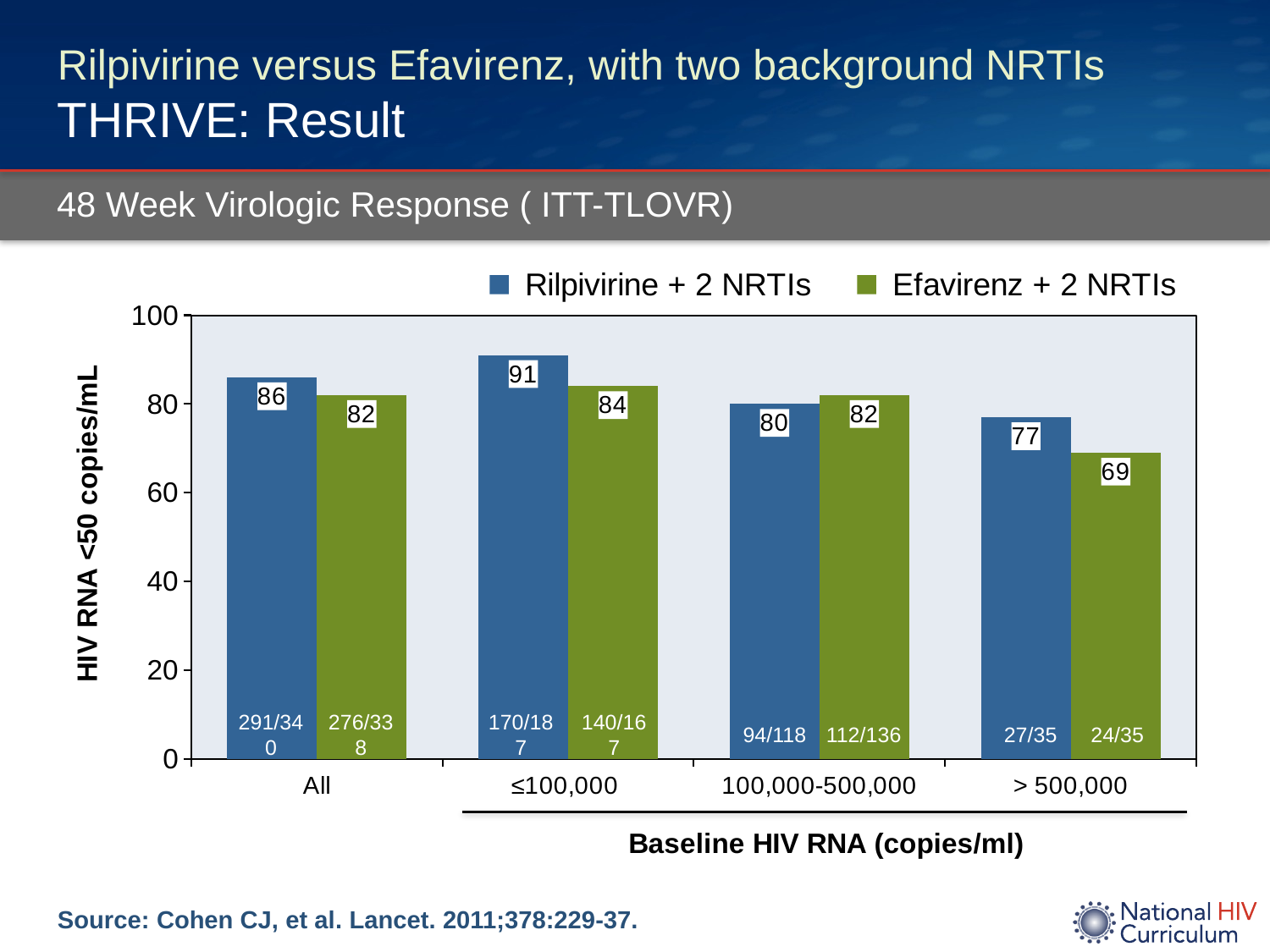
How many baseline HIV RNA categories are shown on the x axis? 4 Which baseline HIV RNA category has the highest value for Rilpivirine + 2 NRTIs? ≤100,000 Is the value for Efavirenz + 2 NRTIs in the > 500,000 category greater or less than 80? less What is the difference between the Rilpivirine + 2 NRTIs and Efavirenz + 2 NRTIs values in the > 500,000 category? 8 In the 100,000-500,000 category, which series has the larger value? Efavirenz + 2 NRTIs What kind of chart is shown on the slide? Bar chart What is the value for Efavirenz + 2 NRTIs in the ≤100,000 category? 84 What is the label of the y axis? HIV RNA <50 copies/mL What is the value for Efavirenz + 2 NRTIs in the > 500,000 category? 69 Which baseline HIV RNA category has the lowest value for Efavirenz + 2 NRTIs? > 500,000 What is the value for Rilpivirine + 2 NRTIs in the All category? 86 How many series does the legend list? 2